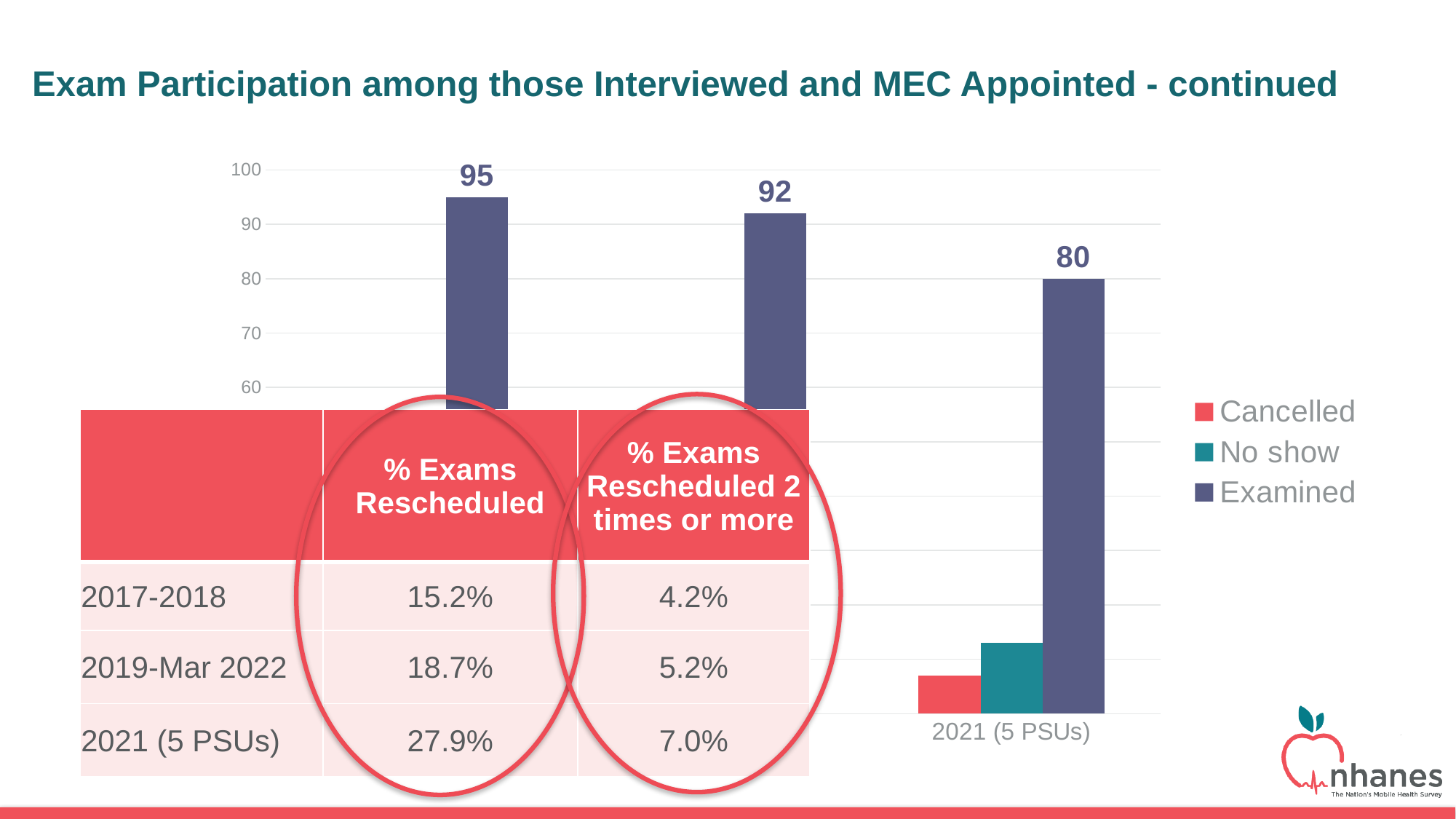
What is the highest Examined value shown in the chart? 95 What kind of chart is shown on the slide? bar chart What is the Examined value for 2021 (5 PSUs)? 80 Is the Examined value for 2021 (5 PSUs) greater or less than 90? less Is the Examined value of the leftmost bar greater or less than 90? greater What is the lowest Examined value shown in the chart? 80 Which is larger, the Examined value of the middle bar or the Examined value for 2021 (5 PSUs)? the middle bar How many series does the chart legend list? 3 Do the Examined values rise or fall from left to right across the chart? fall What is the difference between the Examined values of the leftmost bar and the middle bar? 3 What is the difference between the highest and lowest Examined values in the chart? 15 Which series is shown in red in the chart legend? Cancelled